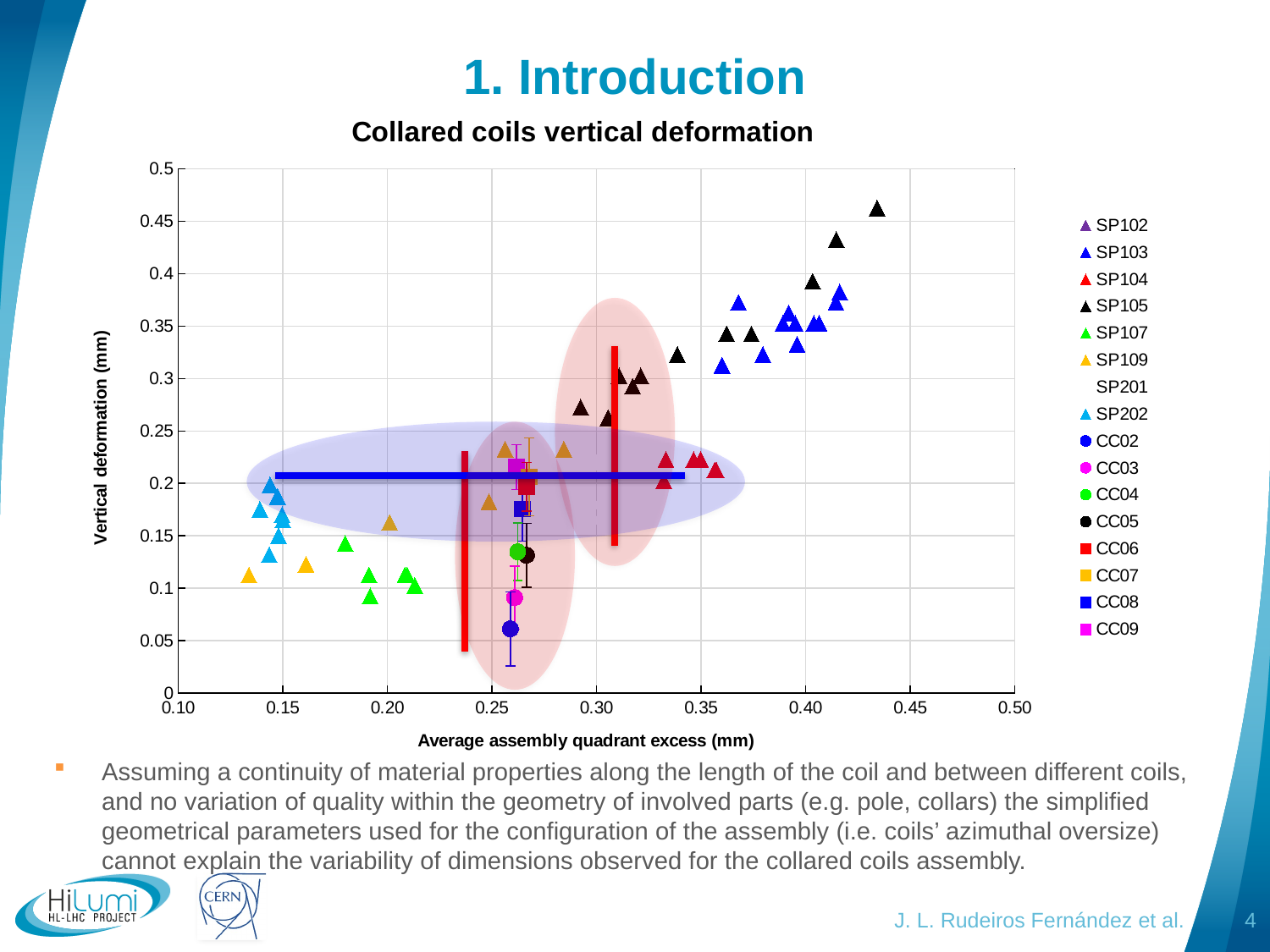
Is the highest vertical deformation among the SP105 points greater or less than 0.45? greater Is the vertical deformation for CC05 greater or less than 0.15? less What is the title of the chart? Collared coils vertical deformation Are all SP202 points below or above a vertical deformation of 0.25? below How many series does the legend list? 16 Which series contains the point with the highest vertical deformation? SP105 What kind of chart is shown on the slide? scatter chart Which series contains the point with the lowest vertical deformation? CC02 What is the label of the horizontal axis? Average assembly quadrant excess (mm) Which has the larger vertical deformation, CC04 or CC02? CC04